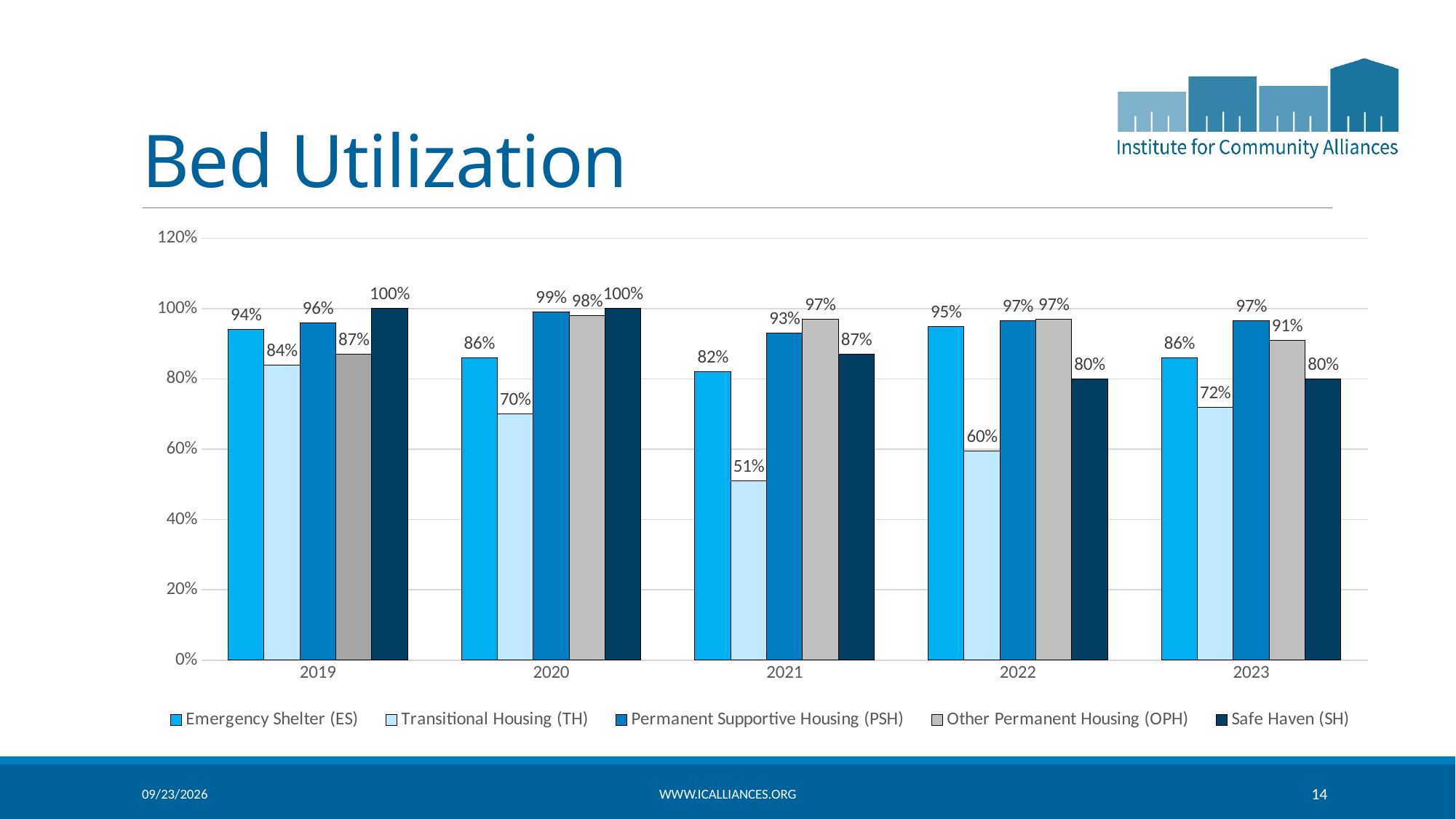
How many series does the legend list? 5 Which year has the highest Emergency Shelter (ES) bed utilization? 2022 Which year has the lowest Transitional Housing (TH) bed utilization? 2021 How many years are shown on the x axis? 5 What is the bed utilization for Emergency Shelter (ES) in 2022? 95% What is the difference between the Permanent Supportive Housing (PSH) and Transitional Housing (TH) values in 2020? 29% In 2019, which is higher: Emergency Shelter (ES) or Other Permanent Housing (OPH)? Emergency Shelter (ES) Does the Safe Haven (SH) bed utilization rise or fall from 2019 to 2023? Fall What is the bed utilization for Safe Haven (SH) in 2020? 100% What is the bed utilization for Other Permanent Housing (OPH) in 2023? 91% What kind of chart is shown on the slide? Bar chart What is the bed utilization for Transitional Housing (TH) in 2021? 51%